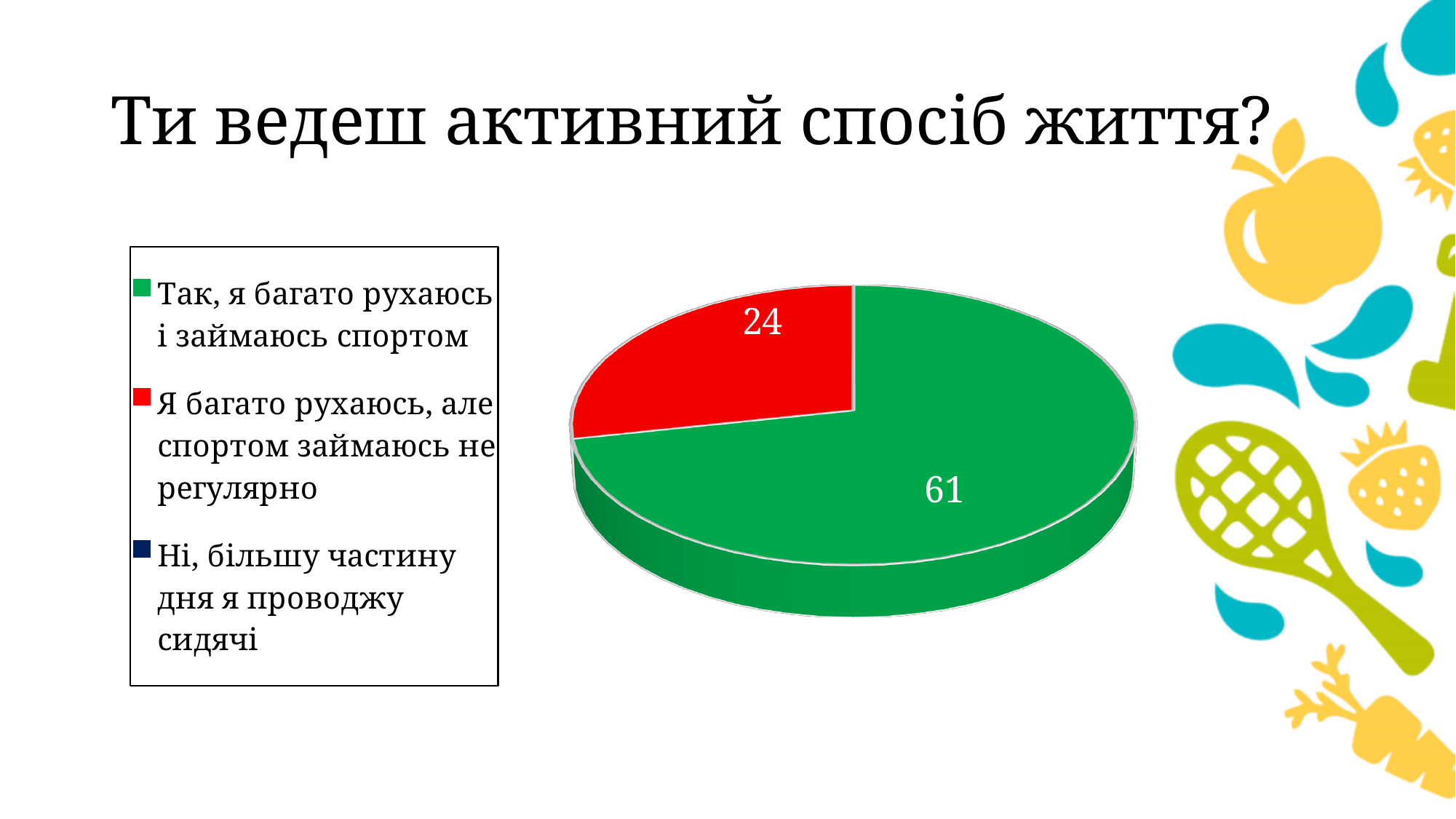
What is the difference between the value for "Так, я багато рухаюсь і займаюсь спортом" and the value for "Я багато рухаюсь, але спортом займаюсь не регулярно"? 37 Which category has the largest slice of the pie? Так, я багато рухаюсь і займаюсь спортом What is the value for "Так, я багато рухаюсь і займаюсь спортом"? 61 How many slices with data labels are visible in the pie? 2 Which of the two labelled slices is smaller? Я багато рухаюсь, але спортом займаюсь не регулярно How many entries does the legend list? 3 What is the title of the slide above the chart? Ти ведеш активний спосіб життя? Which is larger: the value for "Так, я багато рухаюсь і займаюсь спортом" or the value for "Я багато рухаюсь, але спортом займаюсь не регулярно"? Так, я багато рухаюсь і займаюсь спортом What is the value for "Я багато рухаюсь, але спортом займаюсь не регулярно"? 24 What colour is the slice for "Я багато рухаюсь, але спортом займаюсь не регулярно"? red What type of chart is shown on the slide? pie chart